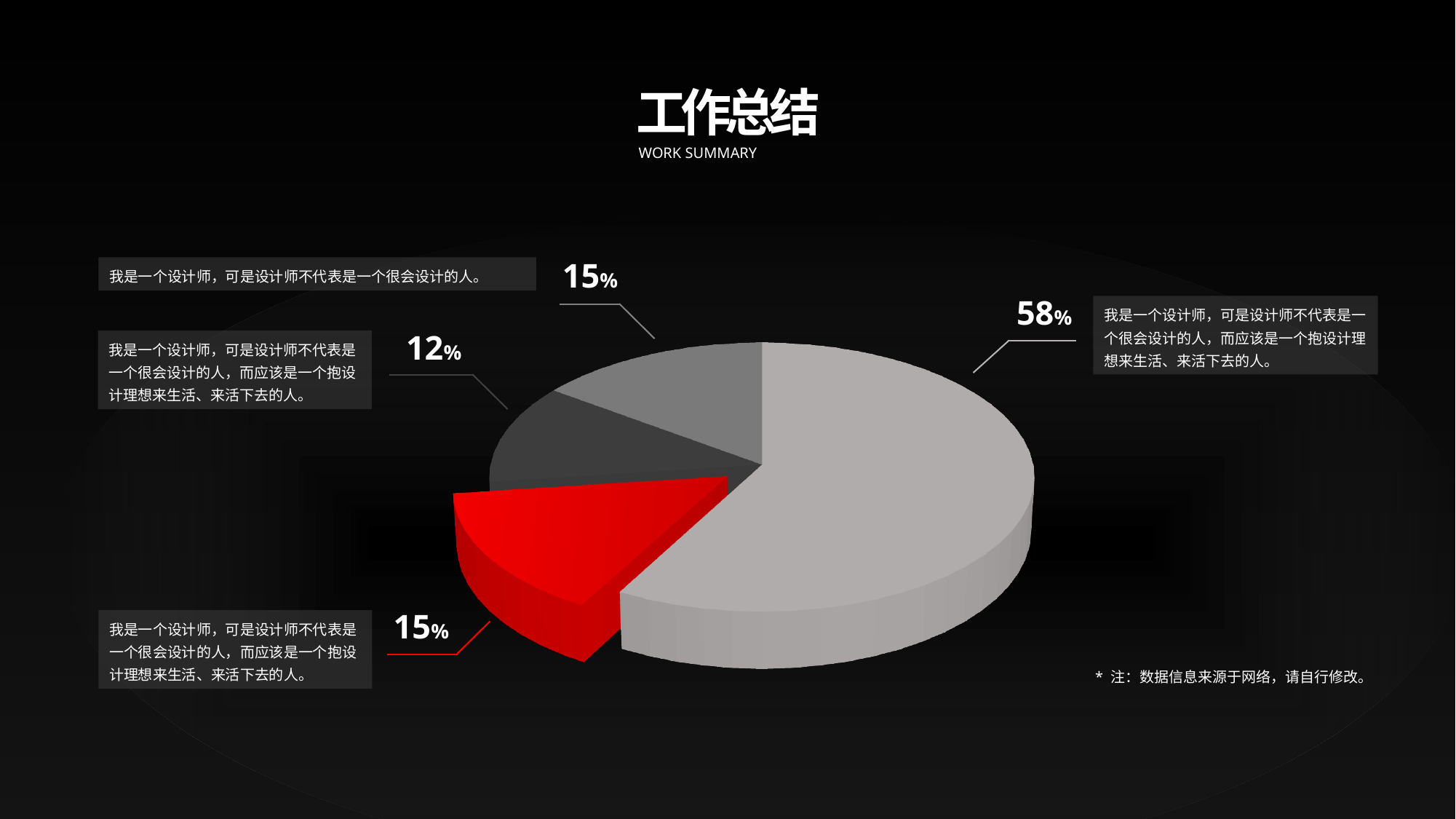
What percentage is shown for the medium gray slice at the top of the pie chart? 15% What percentage is shown for the red slice of the pie chart? 15% What percentage is shown for the largest (light gray) slice of the pie chart? 58% How many slices does the pie chart have? 4 Which is larger: the red slice or the dark gray slice? the red slice What percentage is shown for the dark gray slice on the left of the pie chart? 12% What is the difference in percentage points between the largest slice (58%) and the red slice (15%)? 43 Which slice of the pie chart is pulled out (exploded) from the rest? the red slice Which slice of the pie chart has the largest share? the light gray slice (58%) Which slice of the pie chart has the smallest share? the dark gray slice (12%) What kind of chart is shown on the slide? pie chart What is the title of the slide containing the pie chart? 工作总结 (WORK SUMMARY)